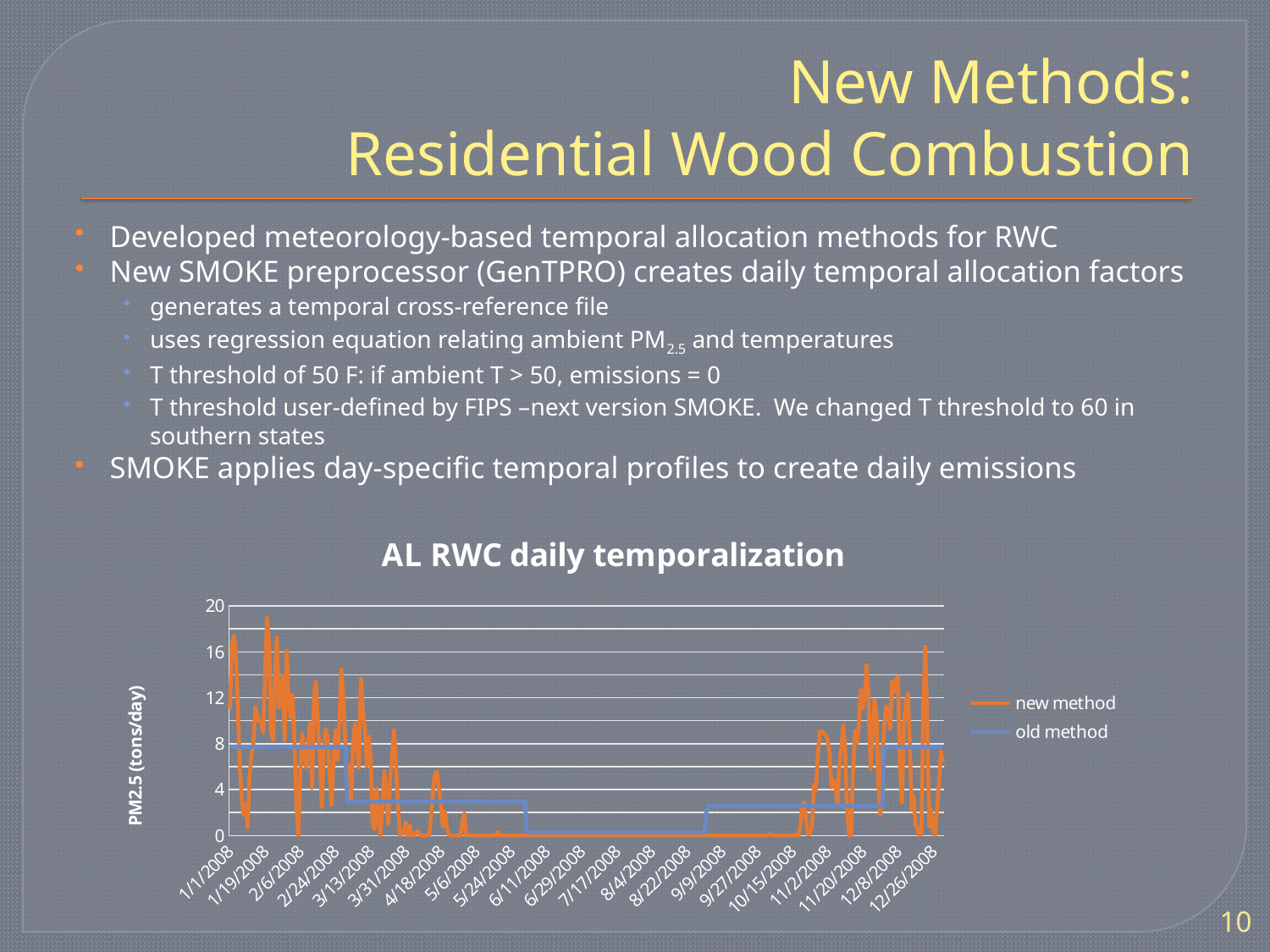
What is the first date label on the horizontal axis of the chart? 1/1/2008 What is the last date label on the horizontal axis of the chart? 12/26/2008 Is the highest peak of the new method series greater or less than 16? greater How many series does the chart legend list? 2 Is the old method value around 7/17/2008 greater or less than 4? less What kind of chart is shown on the slide? line chart What are the two series named in the chart legend? new method, old method What is the title of the chart? AL RWC daily temporalization What is the label of the vertical axis of the chart? PM2.5 (tons/day) What is the highest value shown on the vertical axis of the chart? 20 Is the old method value in mid-January 2008 greater or less than 4? greater Around 9/9/2008, which series has the larger value, new method or old method? old method